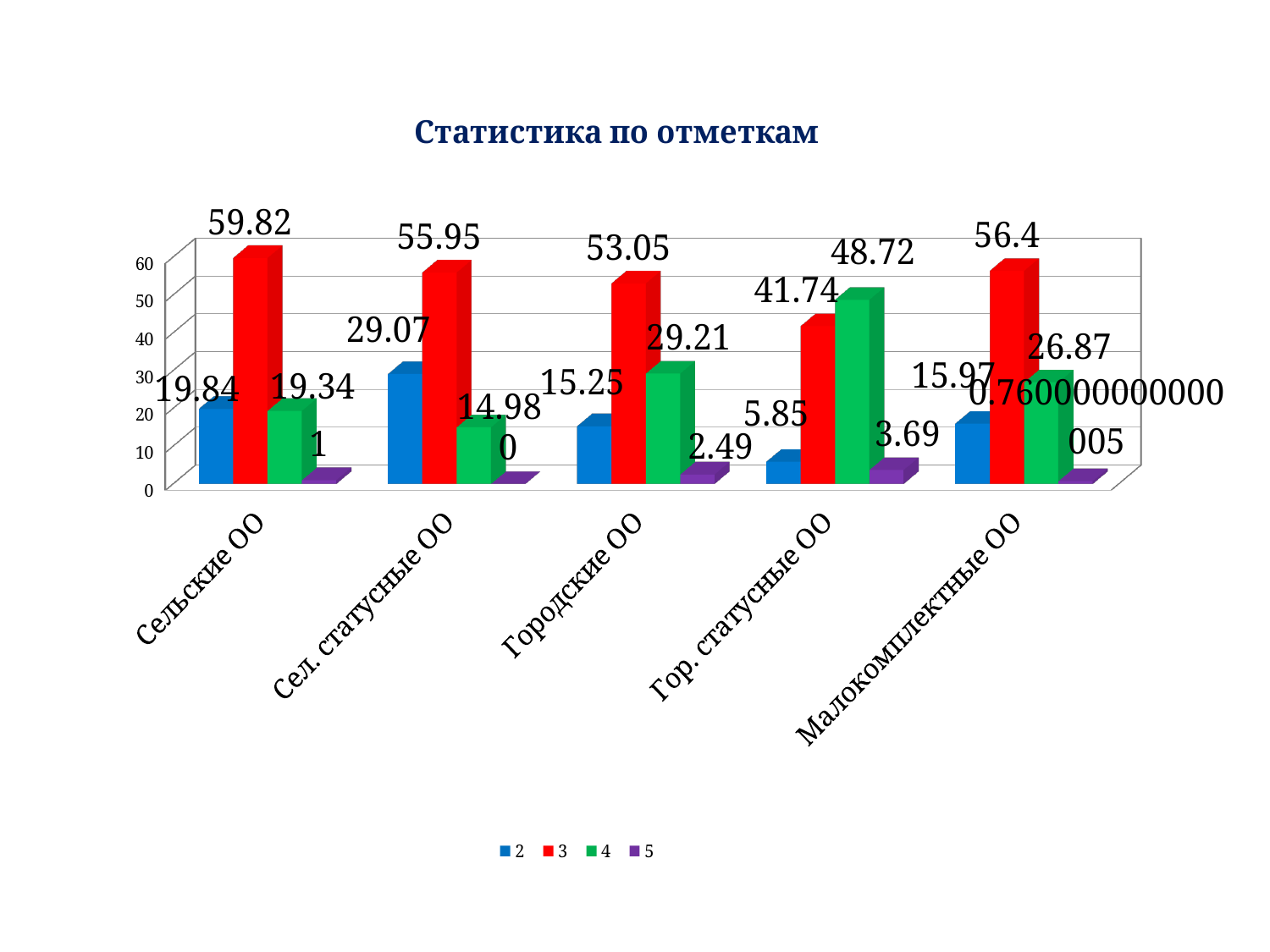
What is the title of the chart? Статистика по отметкам What type of chart is shown on the slide? bar chart What is the value of series 5 for Городские ОО? 2.49 What is the difference between the series 3 value and the series 4 value for Городские ОО? 23.84 How many series does the legend list? 4 Which category has the highest value for series 3? Сельские ОО For Гор. статусные ОО, which is larger: the value for series 3 or the value for series 4? series 4 What is the value of series 4 for Гор. статусные ОО? 48.72 How many categories are shown on the x axis? 5 What is the value of series 2 for Сел. статусные ОО? 29.07 Which category has the lowest value for series 2? Гор. статусные ОО What is the value of series 3 for Сельские ОО? 59.82